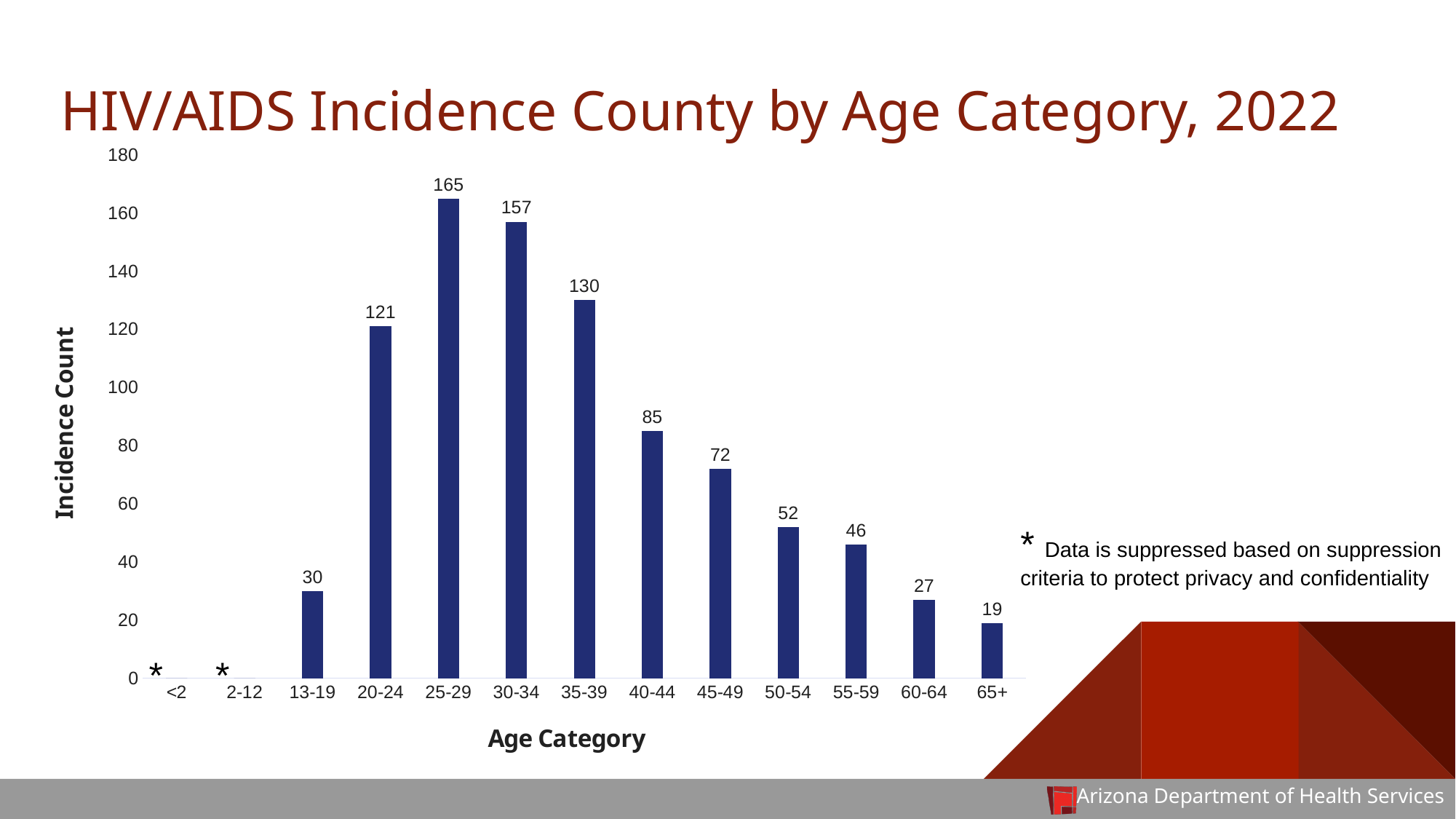
Which age category has a higher incidence count, 20-24 or 35-39? 35-39 How many age categories are shown on the x axis? 13 What is the title of the chart? HIV/AIDS Incidence County by Age Category, 2022 What is the incidence count for the 25-29 age category? 165 What is the difference in incidence count between the 25-29 and 30-34 age categories? 8 Is the value for the 45-49 age category greater or less than 80? less What kind of chart is shown on the slide? Bar chart What is the incidence count for the 40-44 age category? 85 Among the age categories with a plotted value, which has the lowest incidence count? 65+ Which age category has the highest incidence count? 25-29 What is the incidence count for the 65+ age category? 19 Do the incidence counts rise or fall from the 30-34 age category to the 65+ age category? Fall